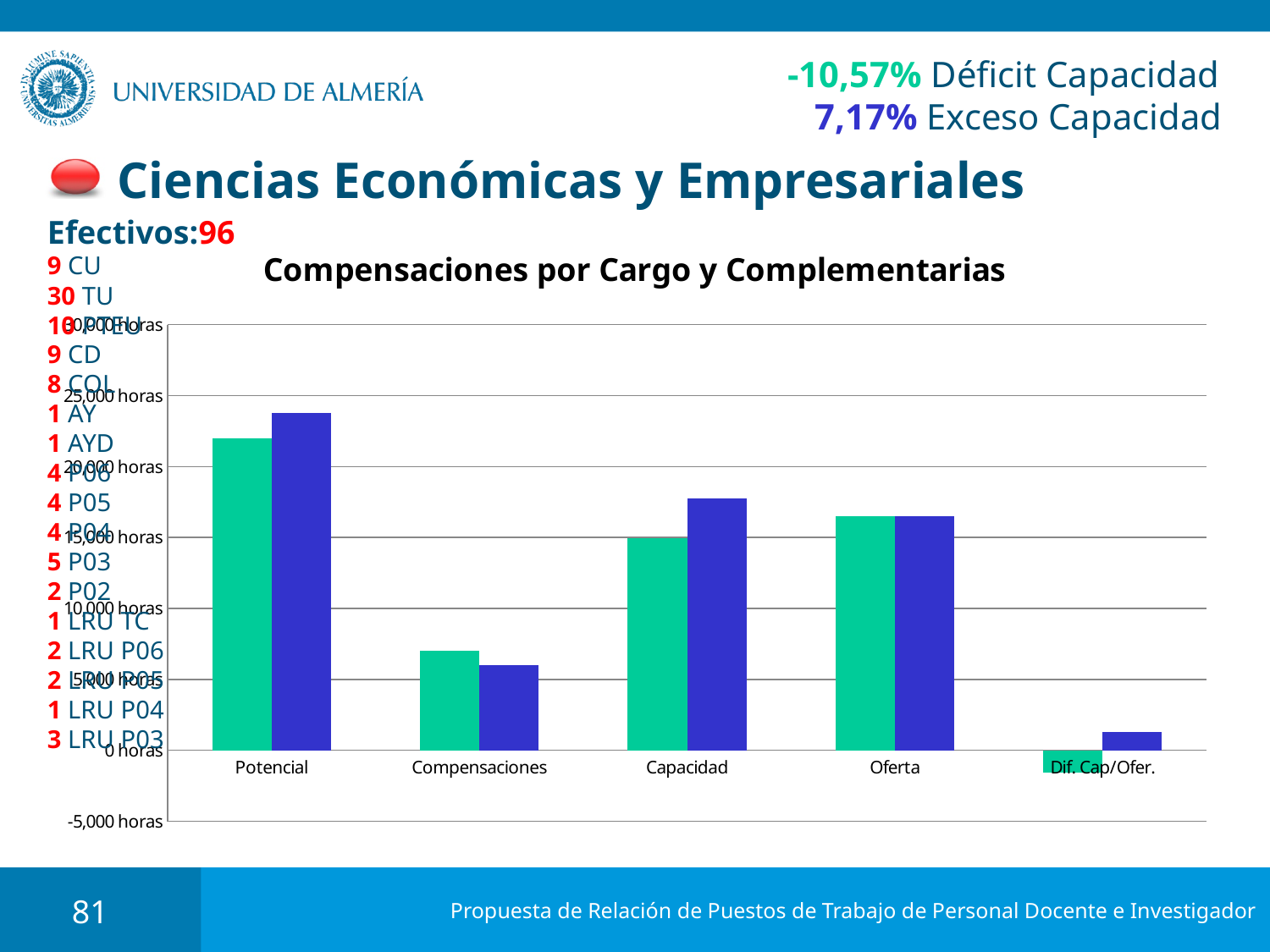
Which category has the lowest bars in the chart? Dif. Cap/Ofer. Is the blue bar for Capacidad greater or less than 15,000 horas? greater Is the teal bar for Capacidad greater or less than 20,000 horas? less What kind of chart is shown on the slide? bar chart Is the teal bar for Potencial greater or less than 20,000 horas? greater Which category has a bar that falls below 0 horas? Dif. Cap/Ofer. Which category has the tallest bars in the chart? Potencial Which is larger for Compensaciones, the teal bar or the blue bar? the teal bar Which is larger for Potencial, the teal bar or the blue bar? the blue bar What is the title of the chart? Compensaciones por Cargo y Complementarias How many categories are shown on the x axis of the chart? 5